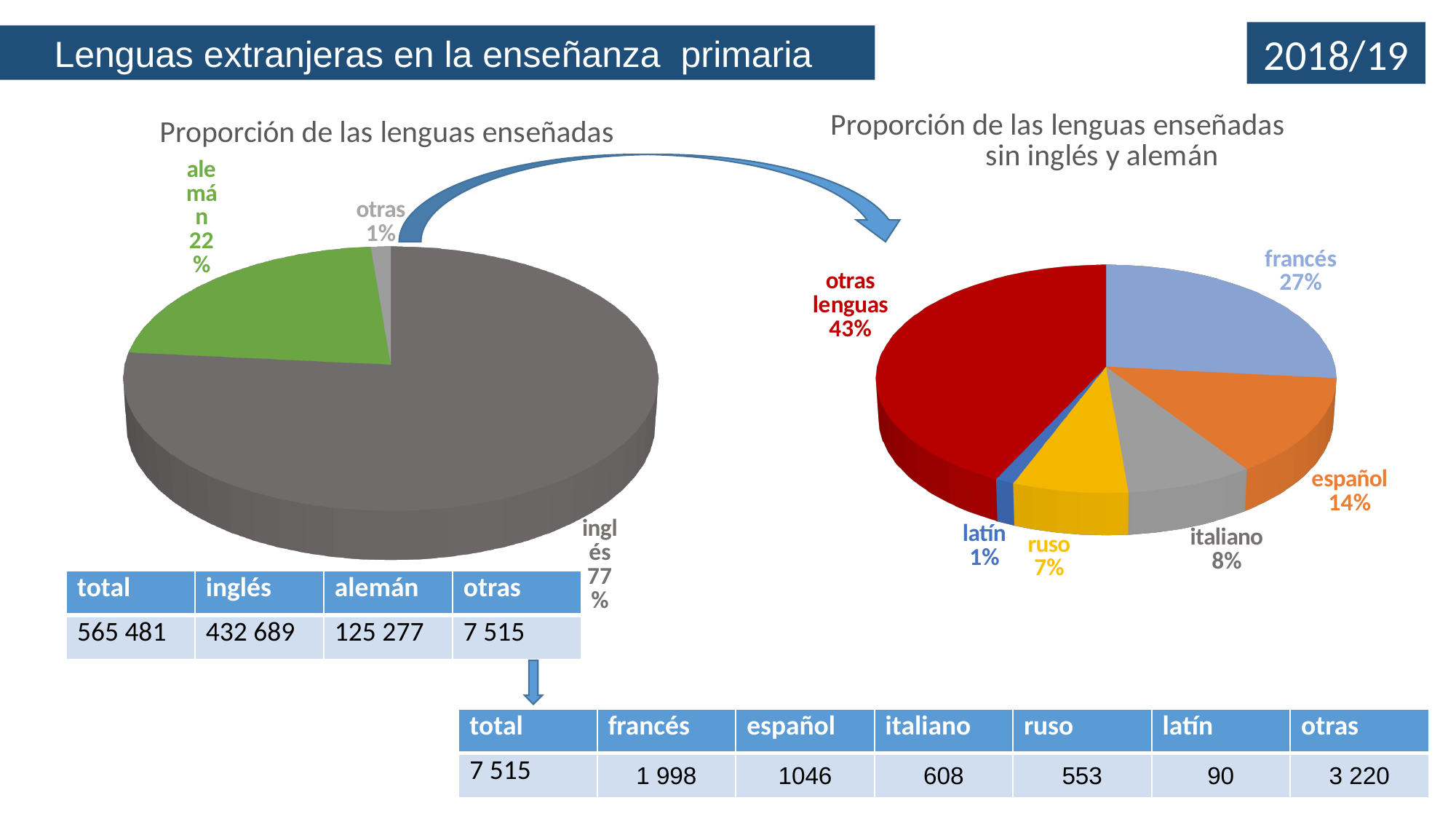
In the right chart 'Proporción de las lenguas enseñadas sin inglés y alemán', which slice is the largest? otras lenguas In the left chart 'Proporción de las lenguas enseñadas', what share does alemán have? 22% In the left chart 'Proporción de las lenguas enseñadas', which slice is the smallest? otras In the right chart 'Proporción de las lenguas enseñadas sin inglés y alemán', what is the difference in percentage points between francés and español? 13 In the right chart 'Proporción de las lenguas enseñadas sin inglés y alemán', what share does español have? 14% In the right chart 'Proporción de las lenguas enseñadas sin inglés y alemán', which is larger, italiano or ruso? italiano In the right chart 'Proporción de las lenguas enseñadas sin inglés y alemán', how many slices does the pie have? 6 In the left chart 'Proporción de las lenguas enseñadas', how many slices does the pie have? 3 In the left chart 'Proporción de las lenguas enseñadas', what share does inglés have? 77% In the right chart 'Proporción de las lenguas enseñadas sin inglés y alemán', which slice is the smallest? latín What kind of chart is the right chart 'Proporción de las lenguas enseñadas sin inglés y alemán'? pie chart